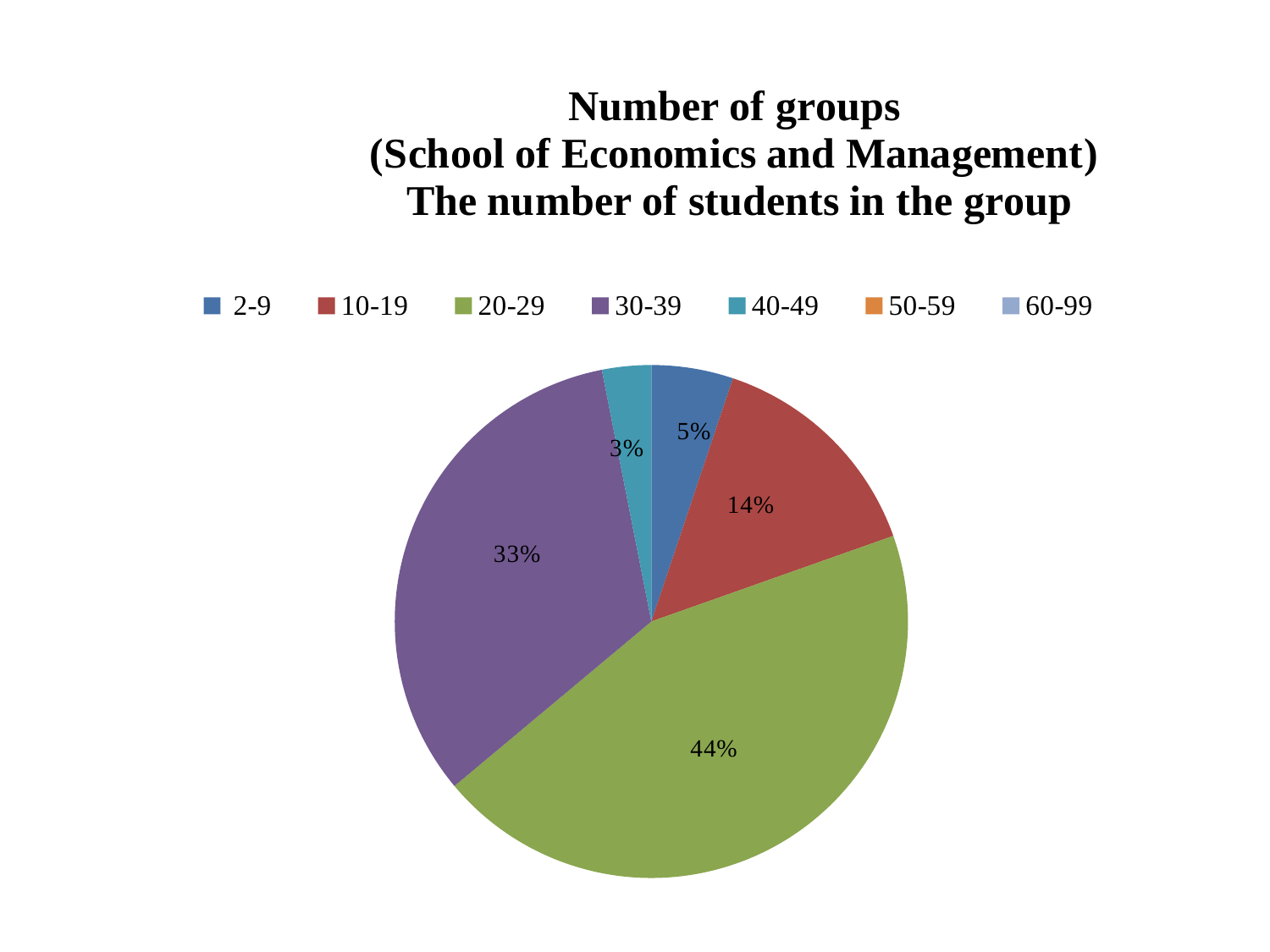
What type of chart is shown on the slide? pie chart Which group size category with a visible slice has the smallest share of the pie? 40-49 What share of the pie does the 20-29 slice represent? 44% What colour is the 30-39 slice of the pie? purple Which slice is larger, 10-19 or 2-9? 10-19 How many categories are listed in the legend? 7 What share of the pie does the 30-39 slice represent? 33% What share of the pie does the 40-49 slice represent? 3% What is the difference in percentage points between the 20-29 slice and the 30-39 slice? 11 Which group size category has the largest slice of the pie? 20-29